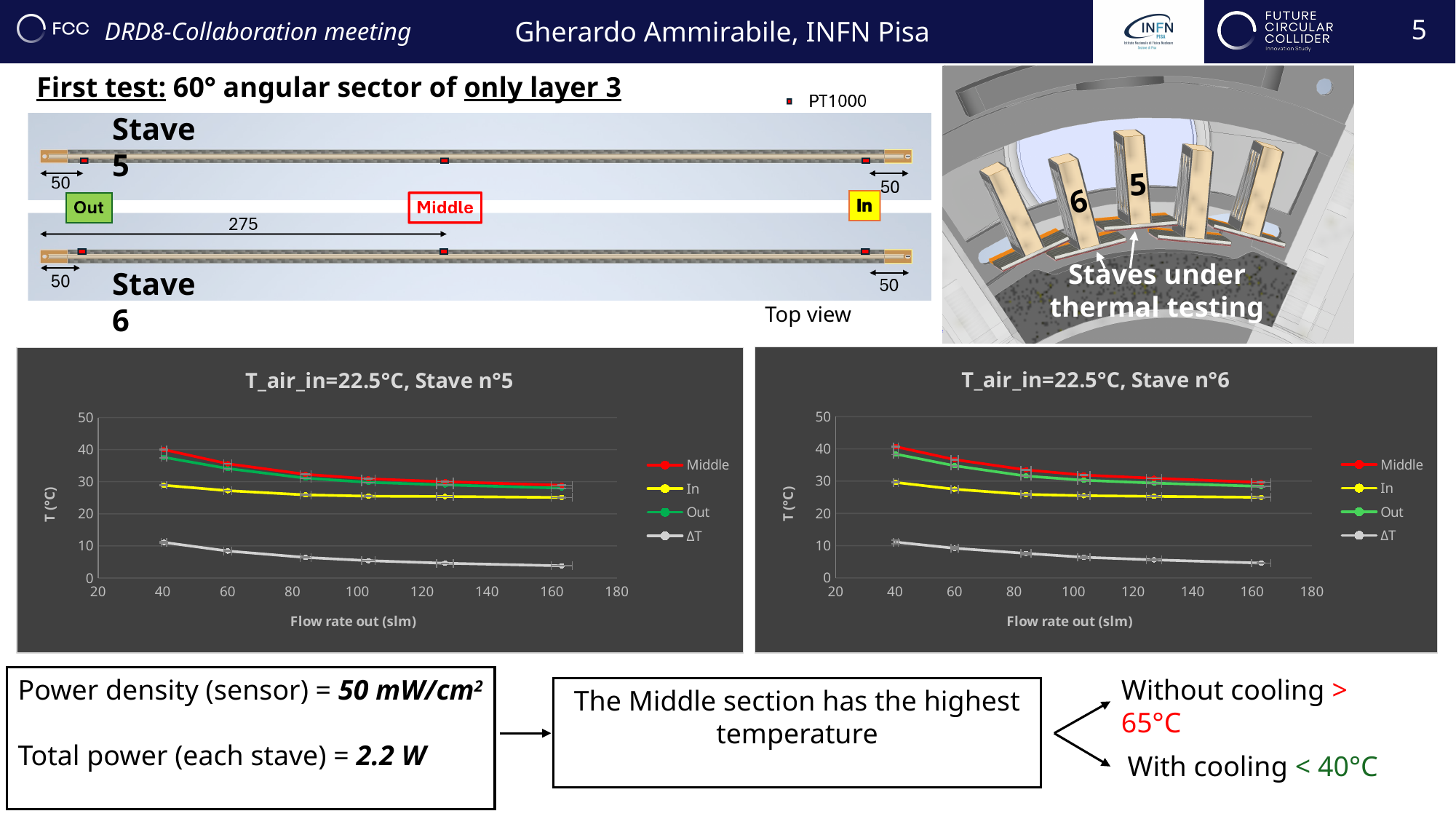
In the chart titled "T_air_in=22.5°C, Stave n°6", which series has the highest temperature at a flow rate of 40 slm? Middle In the chart titled "T_air_in=22.5°C, Stave n°5", what are the four series named in the legend? Middle, In, Out, ΔT In the chart titled "T_air_in=22.5°C, Stave n°5", what kind of chart is shown? line chart In the chart titled "T_air_in=22.5°C, Stave n°6", is the ΔT value at a flow rate of 160 slm greater or less than 10? less In the chart titled "T_air_in=22.5°C, Stave n°5", which series has the lowest values across all flow rates? ΔT In the chart titled "T_air_in=22.5°C, Stave n°6", at a flow rate of 40 slm, is the Middle value or the In value larger? Middle In the chart titled "T_air_in=22.5°C, Stave n°5", what is the label of the x axis? Flow rate out (slm) In the chart titled "T_air_in=22.5°C, Stave n°6", how many series does the legend list? 4 In the chart titled "T_air_in=22.5°C, Stave n°6", does the ΔT series rise or fall as the flow rate increases? fall In the chart titled "T_air_in=22.5°C, Stave n°5", does the Middle temperature rise or fall as the flow rate increases? fall In the chart titled "T_air_in=22.5°C, Stave n°5", is the Middle temperature at a flow rate of 40 slm greater or less than 30? greater In the chart titled "T_air_in=22.5°C, Stave n°5", is the In temperature at a flow rate of 160 slm greater or less than 30? less